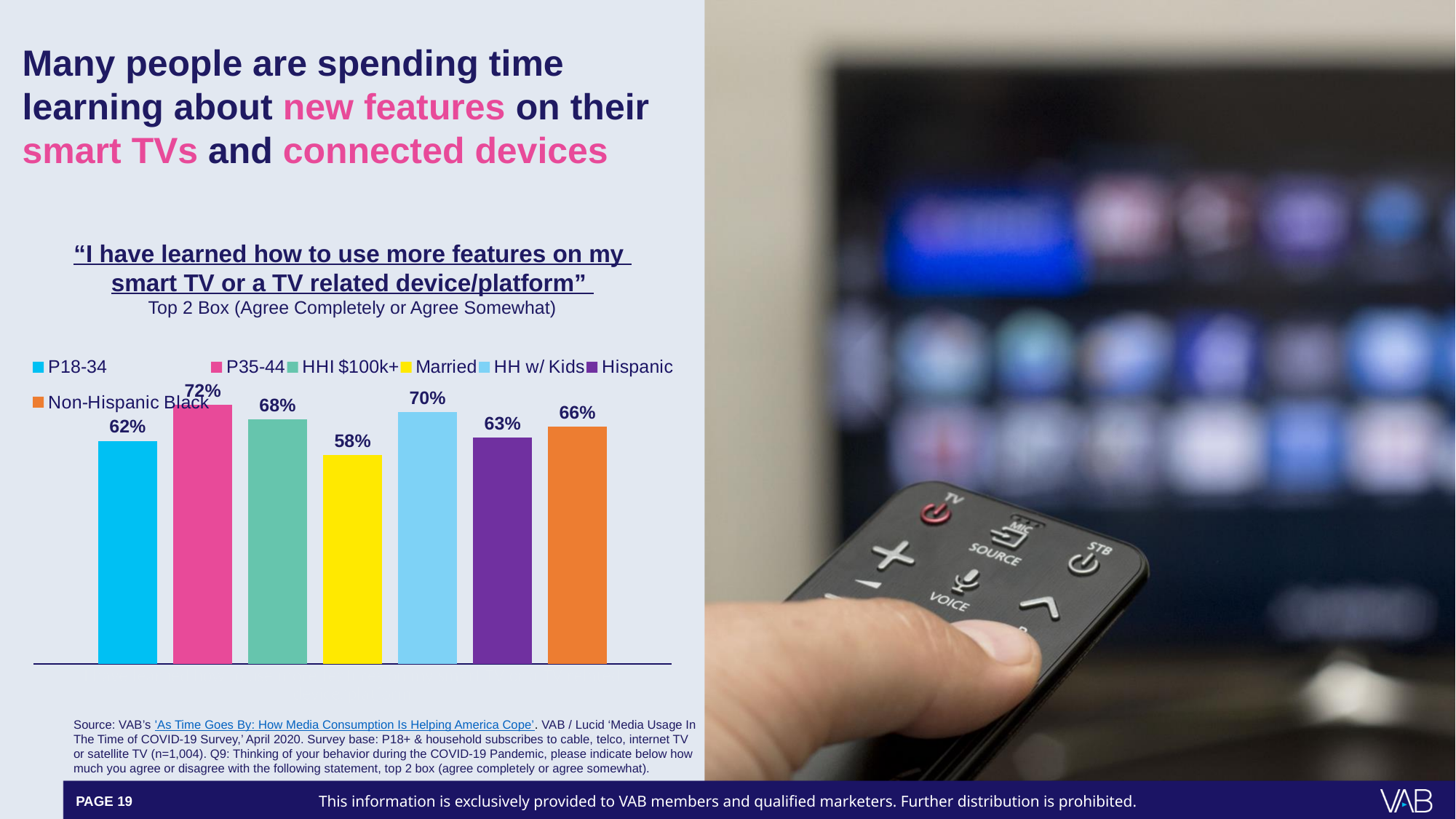
Which is larger, the value for Non-Hispanic Black or the value for Hispanic? Non-Hispanic Black What is the value shown for HH w/ Kids? 70% What is the difference between the HHI $100k+ value and the Hispanic value? 5% What is the difference between the P35-44 value and the Married value? 14% How many bars are plotted in the chart? 7 Which group has the lowest percentage agreeing with the statement? Married What is the value shown for P35-44? 72% What is the value shown for Married respondents? 58% What kind of chart is shown on the slide? Bar chart How many entries does the chart legend list? 7 Which group has the highest percentage agreeing with the statement? P35-44 What percentage of P18-34 agree they have learned how to use more features on their smart TV or TV related device? 62%